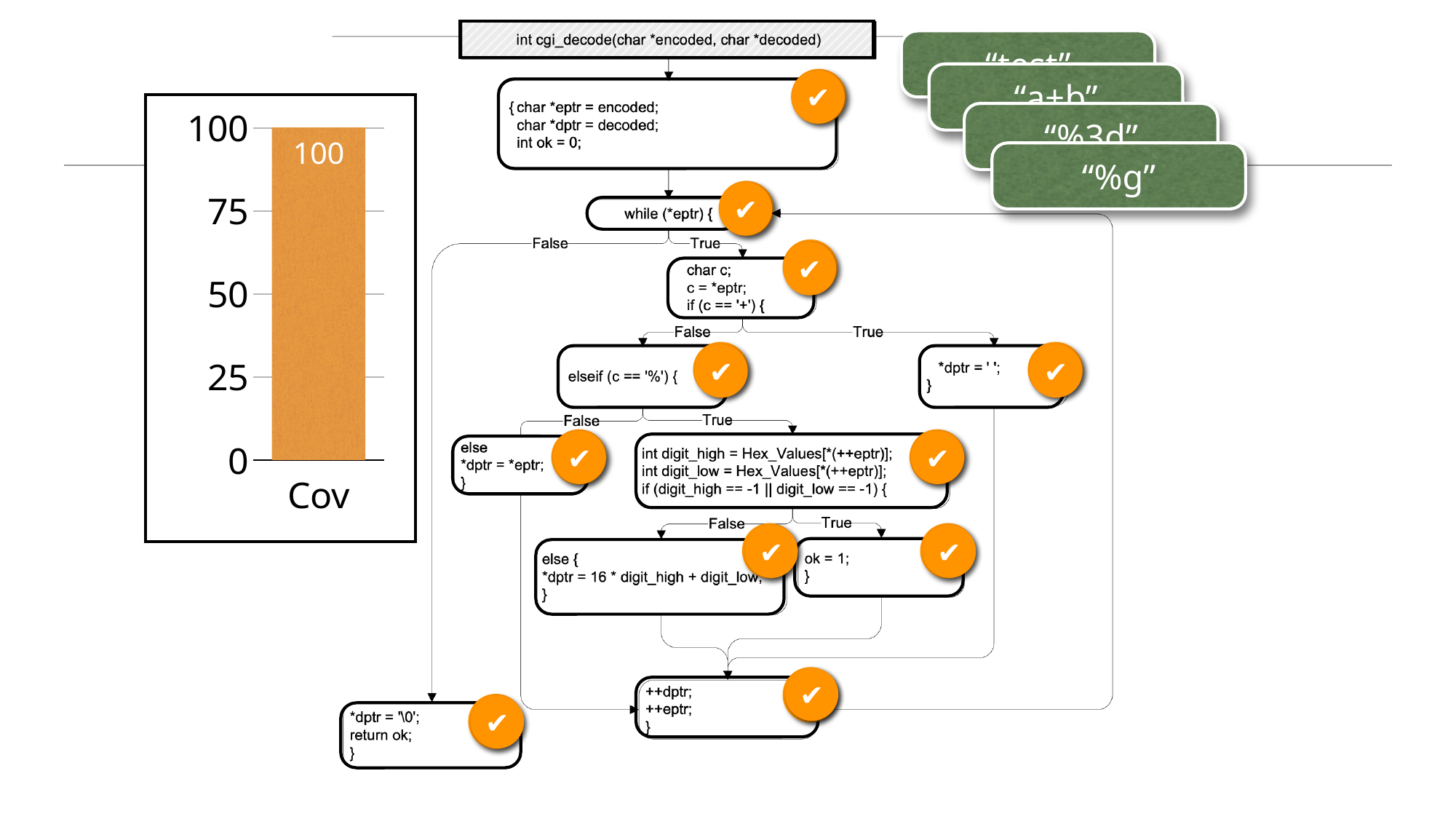
How many bars does the chart show? 1 What kind of chart is shown on the left of the slide? bar chart Is the value for Cov greater or less than 50? greater What is the value of the Cov bar in the bar chart? 100 What is the highest tick value shown on the chart's vertical axis? 100 Is the value for Cov greater or less than 75? greater What is the category label under the bar in the chart? Cov